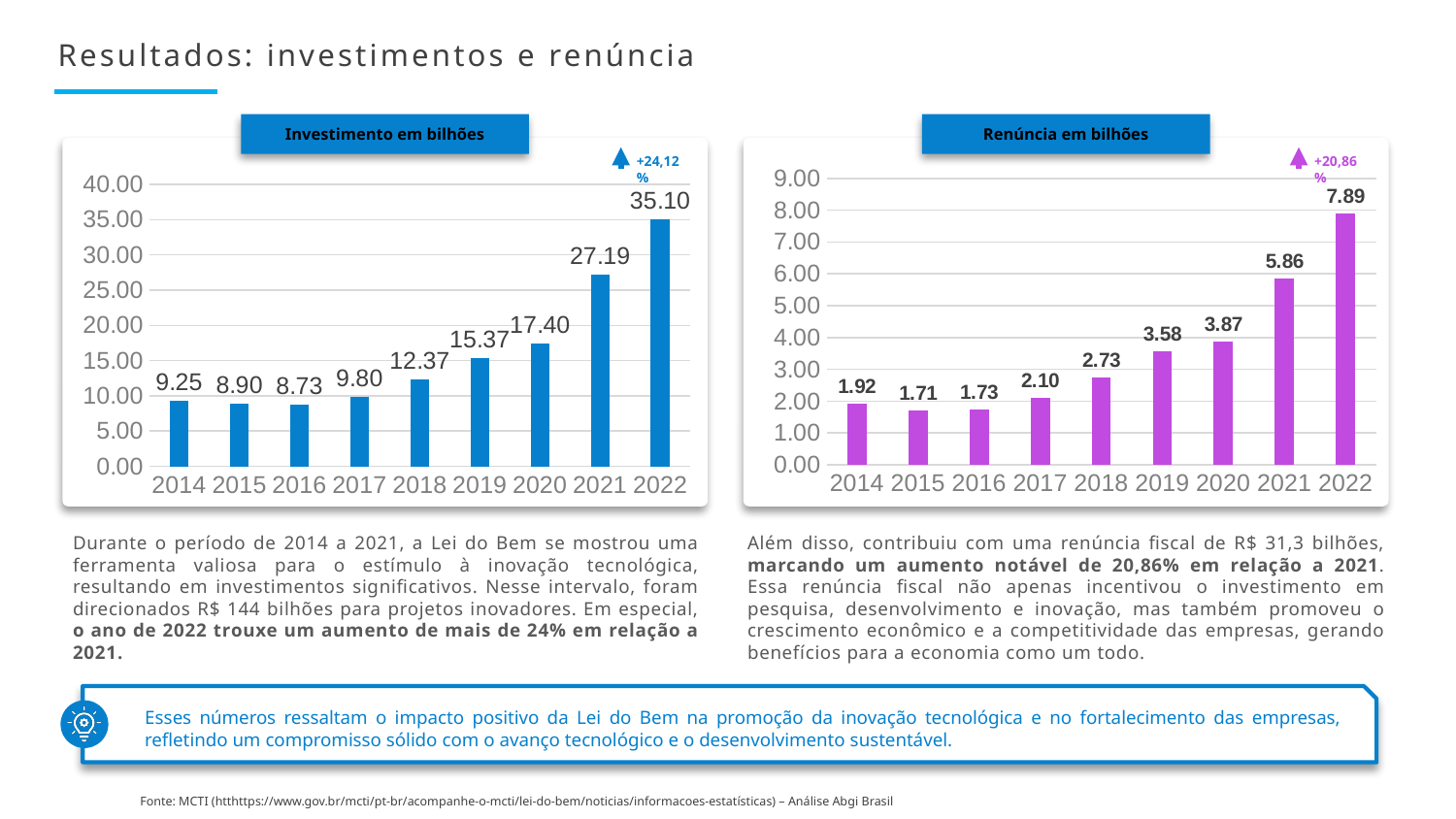
In the 'Renúncia em bilhões' chart, what is the value for 2015? 1.71 In the 'Investimento em bilhões' chart, what is the value for 2022? 35.10 In the 'Renúncia em bilhões' chart, what is the difference between the 2022 and 2021 values? 2.03 In the 'Renúncia em bilhões' chart, what is the value for 2021? 5.86 In the 'Investimento em bilhões' chart, what is the value for 2018? 12.37 In the 'Renúncia em bilhões' chart, which is larger, the value for 2019 or the value for 2020? 2020 In the 'Investimento em bilhões' chart, do the values generally rise or fall from 2017 to 2022? Rise In the 'Investimento em bilhões' chart, which year has the lowest value? 2016 In the 'Renúncia em bilhões' chart, which year has the highest value? 2022 In the 'Investimento em bilhões' chart, how many years are shown on the x axis? 9 What kind of chart is the 'Renúncia em bilhões' chart? Bar chart In the 'Investimento em bilhões' chart, what is the difference between the 2022 and 2021 values? 7.91